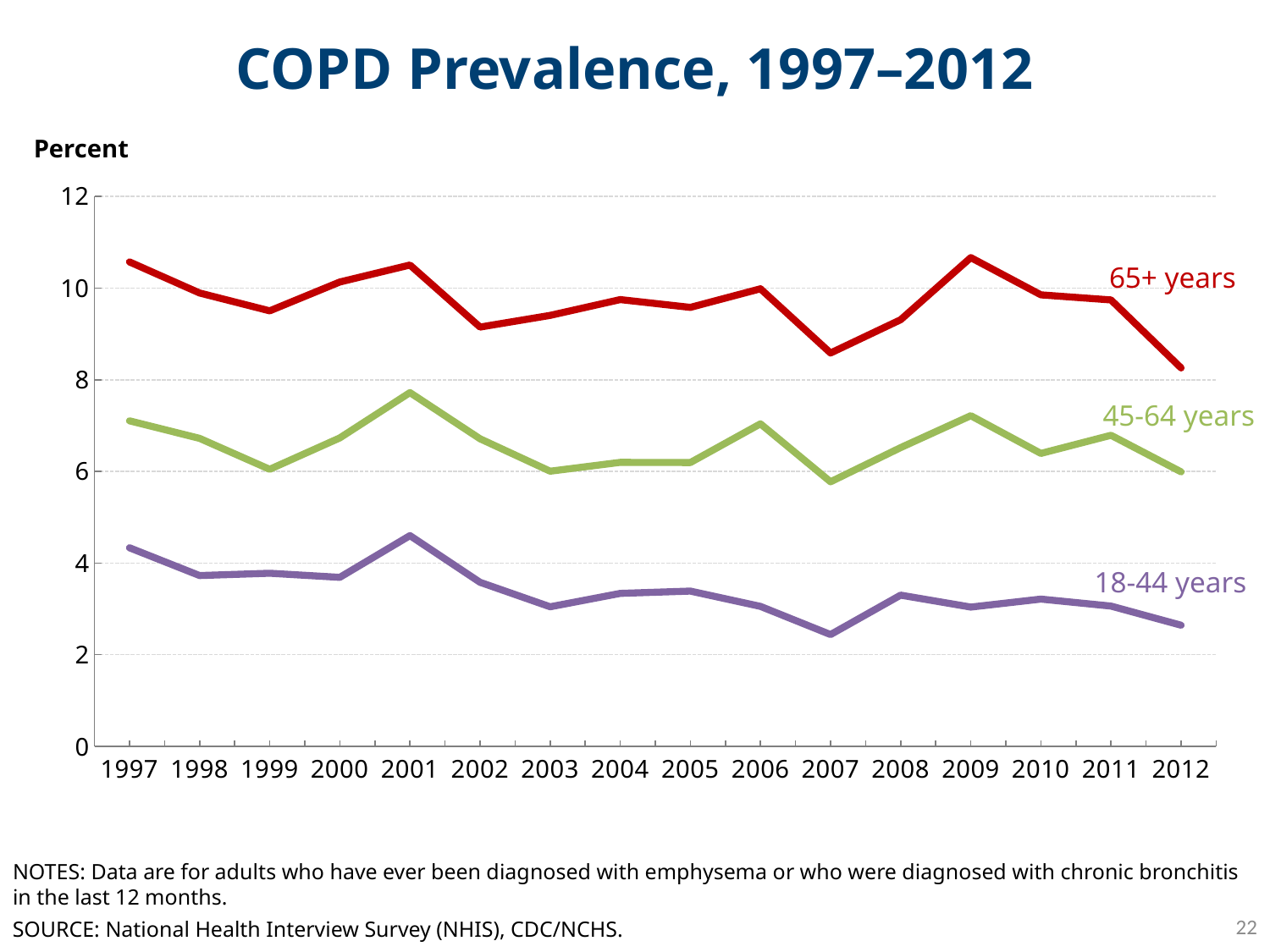
What is the title of the chart? COPD Prevalence, 1997–2012 Which age group has the highest COPD prevalence across all years shown? 65+ years How many years are shown along the x axis? 16 Does the 65+ years line rise or fall from 2009 to 2012? Fall How many age-group series are plotted on the chart? 3 Is the value for 65+ years in 1997 greater or less than 10? greater Is the value for 45-64 years in 2001 greater or less than 6? greater What kind of chart is shown on the slide? Line chart Is the value for 65+ years in 2012 greater or less than 10? less In which year does the 45-64 years line reach its highest value? 2001 What is the label on the y axis? Percent